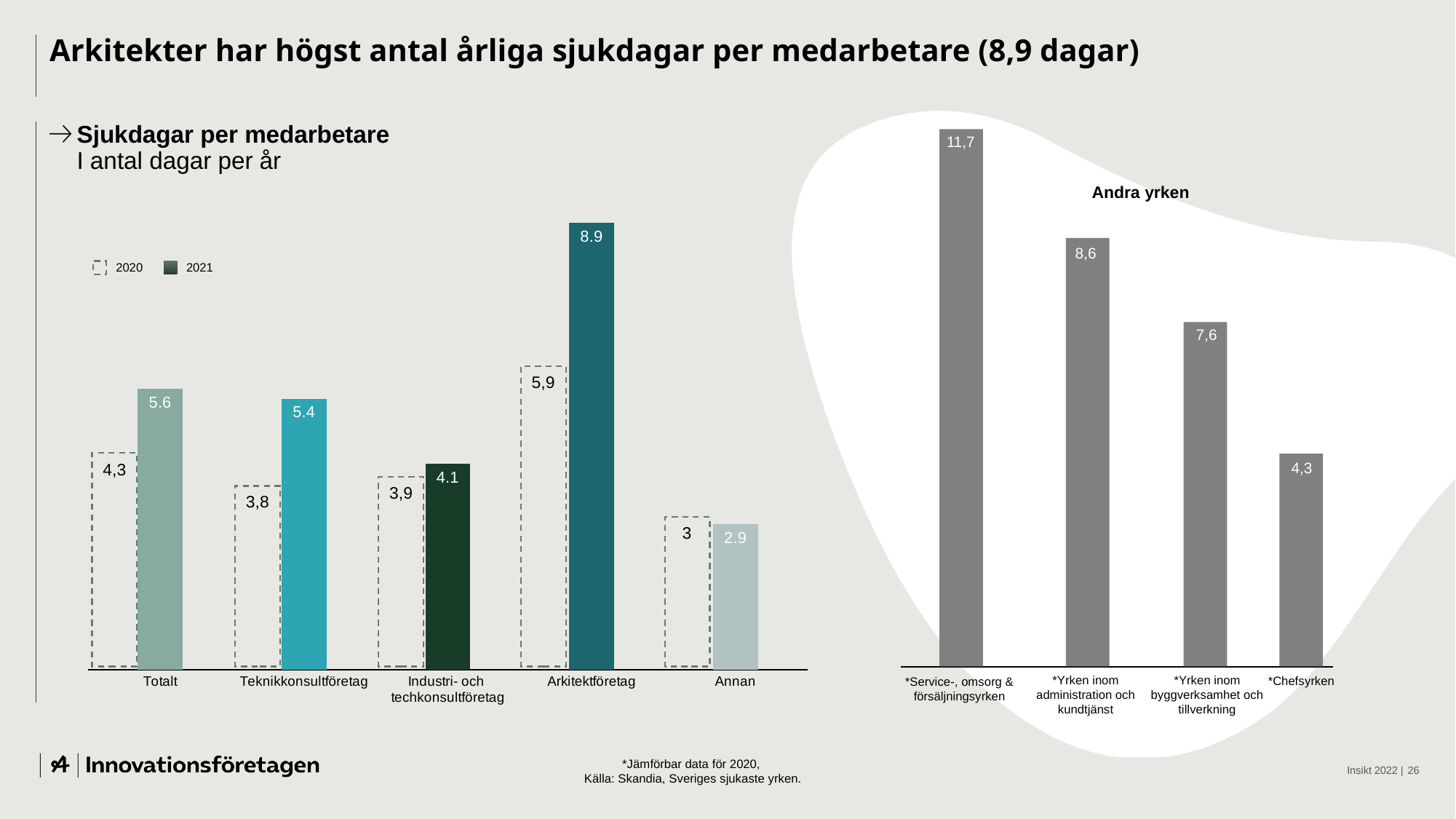
In the 'Sjukdagar per medarbetare' chart, which category has the highest 2021 value? Arkitektföretag What kind of chart is the 'Andra yrken' chart? bar chart In the 'Sjukdagar per medarbetare' chart, what is the 2021 value for Arkitektföretag? 8.9 In the 'Sjukdagar per medarbetare' chart, how many series does the legend list? 2 In the 'Sjukdagar per medarbetare' chart, what is the 2020 value for Teknikkonsultföretag? 3,8 In the 'Andra yrken' chart, which category has the highest value? *Service-, omsorg & försäljningsyrken In the 'Sjukdagar per medarbetare' chart, how many categories are shown on the x axis? 5 In the 'Sjukdagar per medarbetare' chart, is the 2021 value for Totalt larger or smaller than the 2020 value for Totalt? larger In the 'Sjukdagar per medarbetare' chart, which category has the lowest 2020 value? Annan In the 'Sjukdagar per medarbetare' chart, what is the difference between the 2021 and 2020 values for Arkitektföretag? 3 In the 'Andra yrken' chart, what is the value for Chefsyrken? 4,3 In the 'Andra yrken' chart, do the values rise or fall from left to right? fall